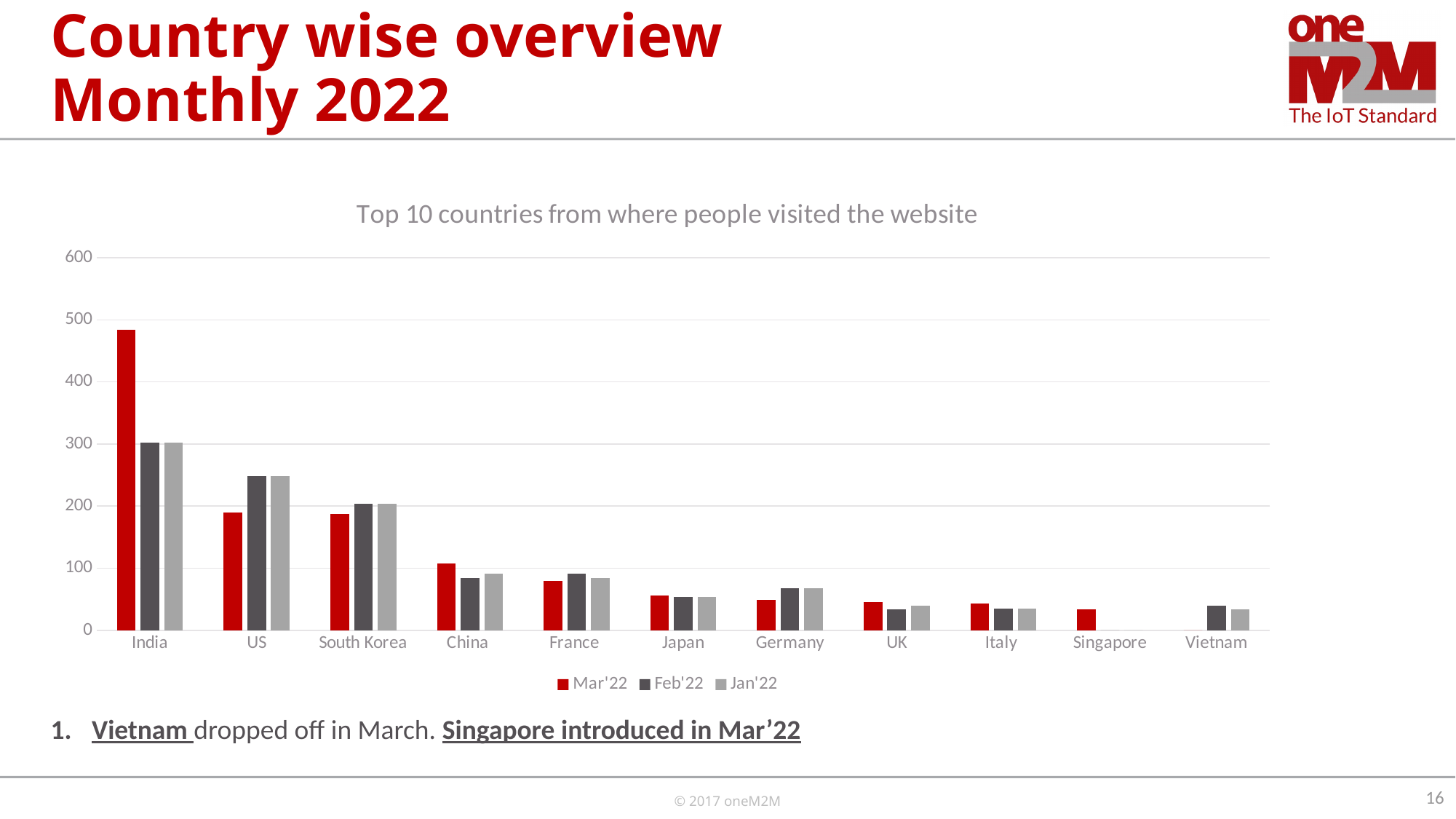
How many countries are shown on the x axis? 11 What kind of chart is shown on the slide? bar chart Is the Mar'22 value for India greater or less than 400? greater Is the Mar'22 value for France greater or less than 100? less How many series does the legend list? 3 Do the Mar'22 values generally rise or fall from India to Singapore along the x axis? fall Which is larger for Germany: the Mar'22 value or the Feb'22 value? Feb'22 What is the title of the chart? Top 10 countries from where people visited the website Is the Feb'22 value for US greater or less than 200? greater Which is larger for US: the Mar'22 value or the Feb'22 value? Feb'22 Which country has the highest Mar'22 value? India